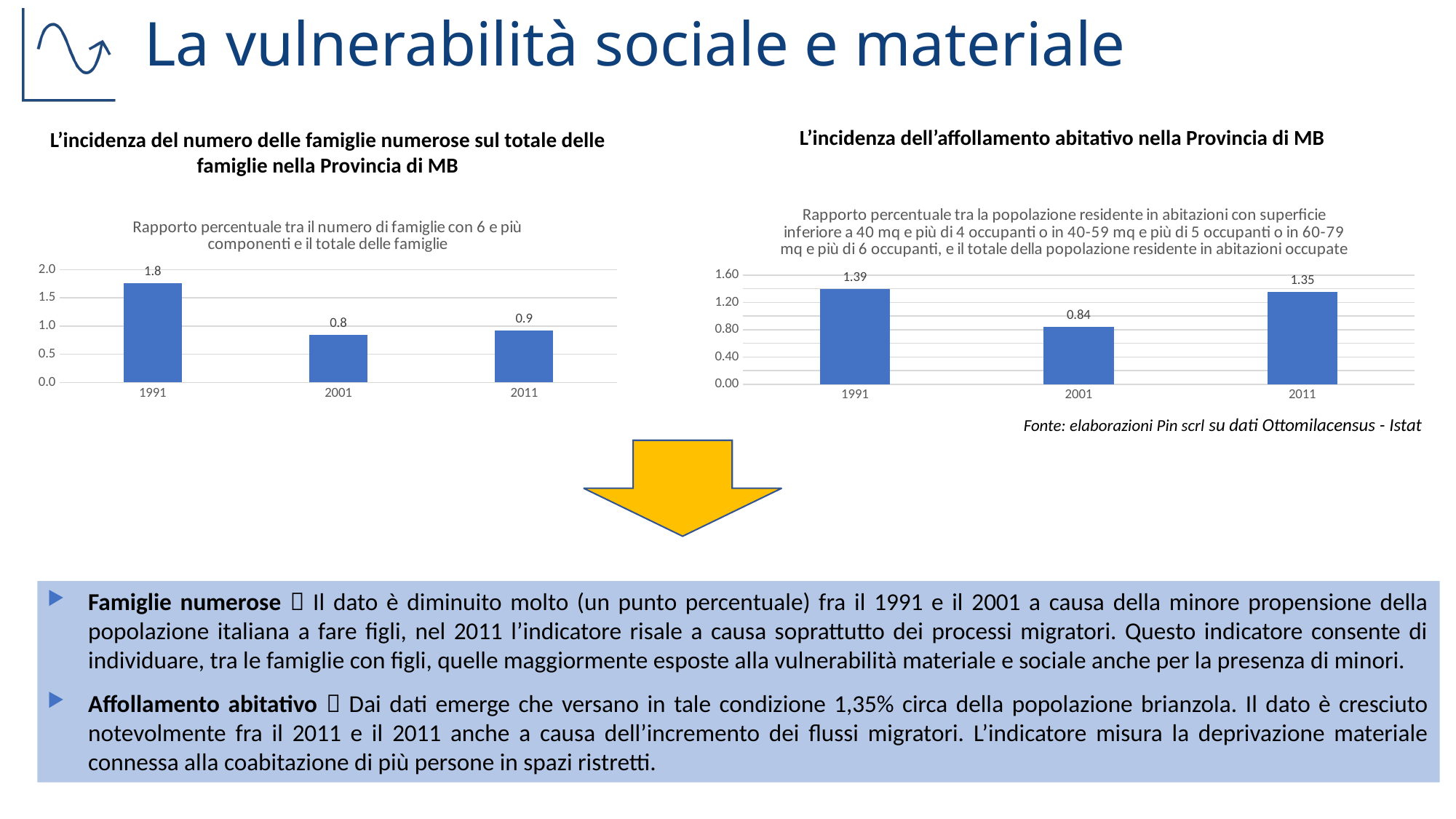
In the right chart (affollamento abitativo), what is the difference between the 2011 and 2001 values? 0.51 In the right chart (affollamento abitativo), what is the value for 2001? 0.84 In the left chart (famiglie numerose), is the value for 2011 greater or less than 1.0? less In the left chart (famiglie numerose), how many years are shown on the x axis? 3 In the right chart (affollamento abitativo), what is the value for 2011? 1.35 In the right chart (affollamento abitativo), which year has the lowest value? 2001 In the left chart (famiglie numerose), what is the difference between the 1991 and 2001 values? 1.0 In the left chart (famiglie numerose), what is the value for 1991? 1.8 In the left chart (famiglie numerose), which year has the highest value? 1991 What type of chart is the right chart (affollamento abitativo)? Bar chart In the right chart (affollamento abitativo), which is larger, the value for 1991 or the value for 2011? 1991 In the left chart (famiglie numerose), what is the value for 2001? 0.8